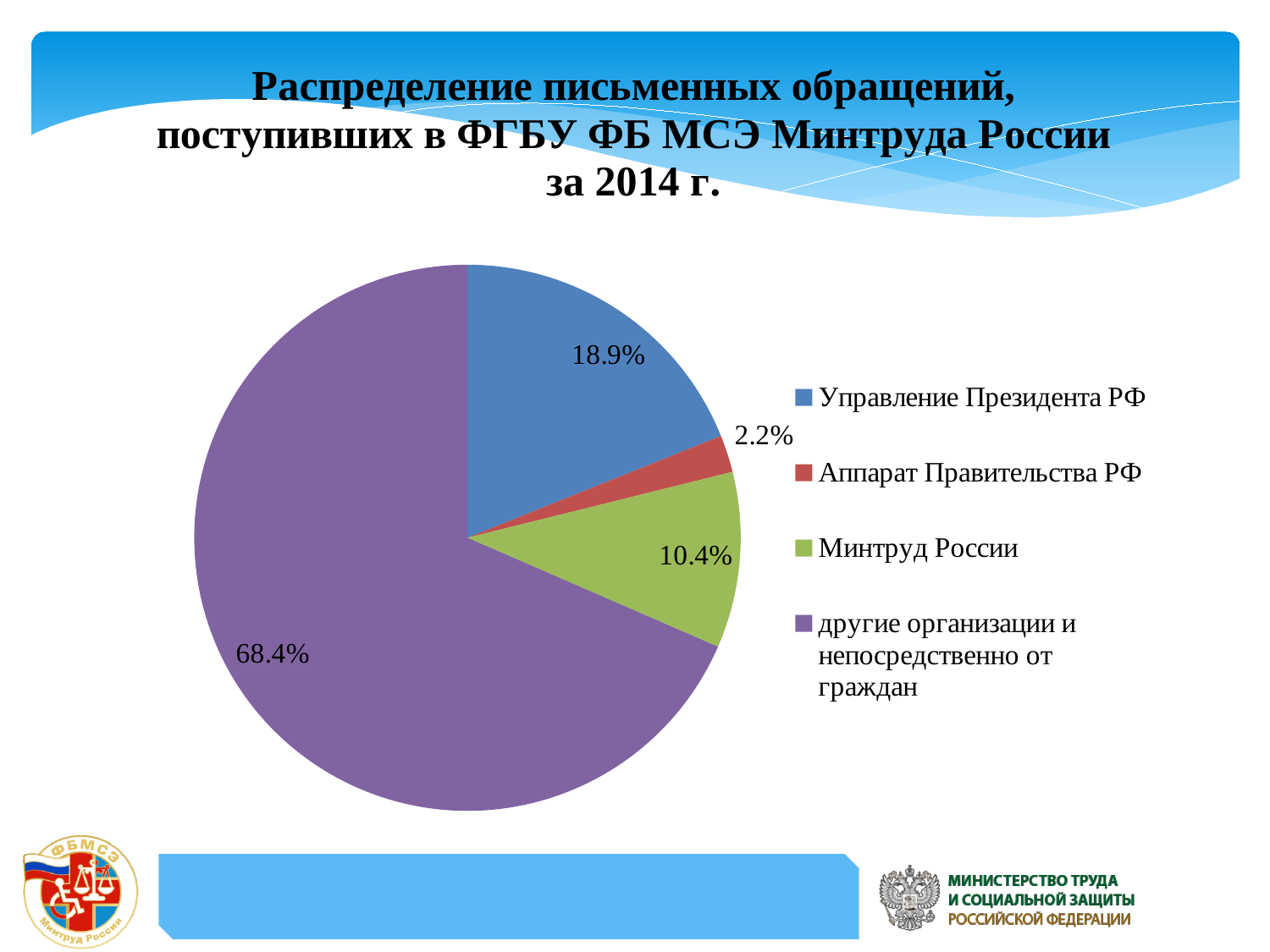
What year does the chart title say the data is for? 2014 What share of written appeals came from Аппарат Правительства РФ? 2.2% What share of written appeals came from Минтруд России? 10.4% Which is larger: the share for Управление Президента РФ or the share for Минтруд России? Управление Президента РФ Which category has the largest share of the pie? другие организации и непосредственно от граждан Which category has the smallest share of the pie? Аппарат Правительства РФ What colour is the slice for Минтруд России? green How many categories does the legend list? 4 What share of written appeals came from другие организации и непосредственно от граждан? 68.4% What share of written appeals came from Управление Президента РФ? 18.9% What kind of chart is shown on the slide? pie chart What is the difference in percentage points between Управление Президента РФ and Минтруд России? 8.5